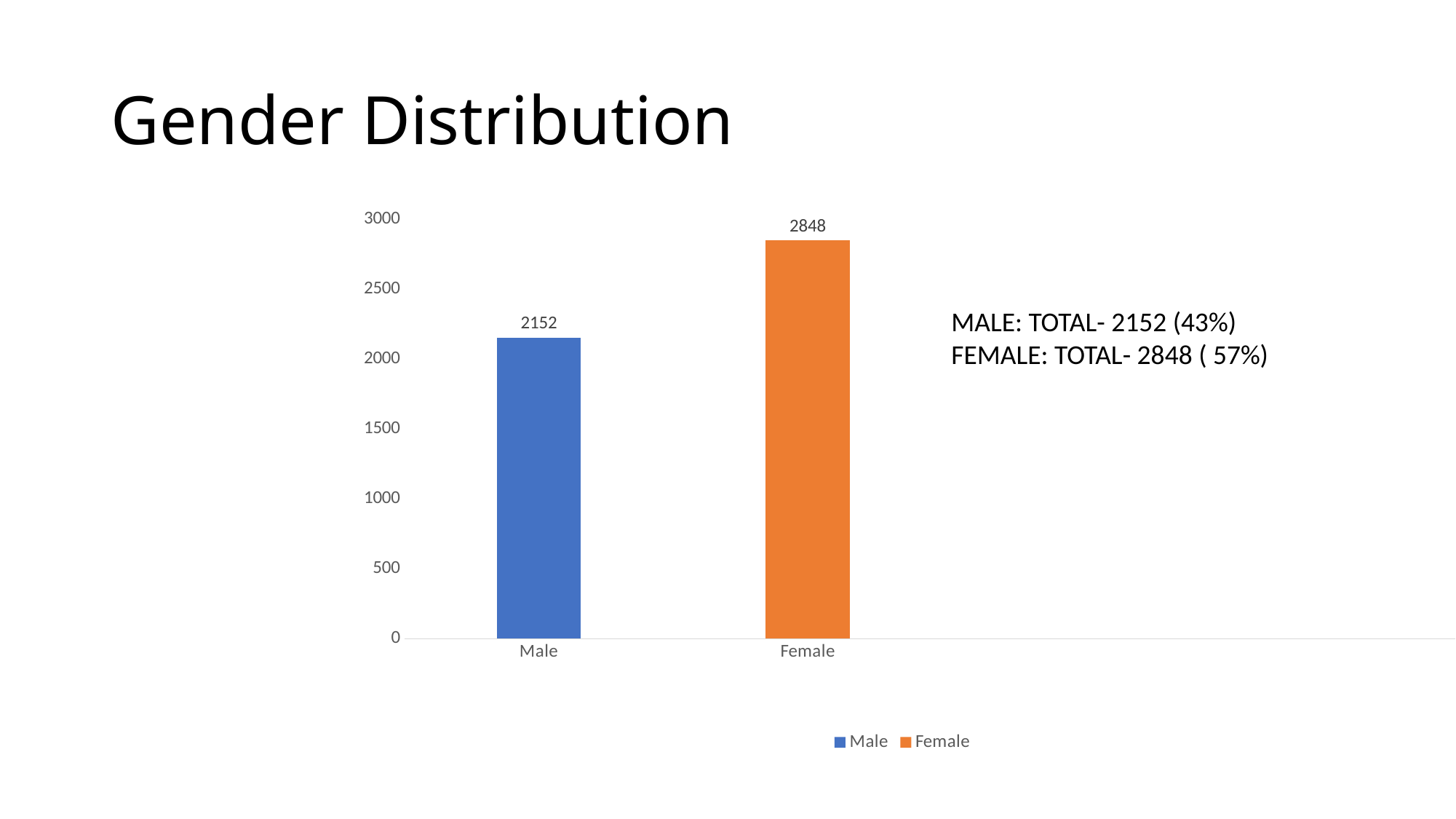
Which category has the lowest value? Male What is the value for Female? 2848 How many categories are shown on the x axis? 2 What colour is the Female bar? orange What is the value for Male? 2152 Is the value for Male greater or less than 2500? less Is the value for Female greater or less than 2500? greater Which is larger, the value for Male or the value for Female? Female What is the difference between the Female and Male values? 696 Which category has the highest value? Female What kind of chart is shown on the slide? bar chart How many entries does the legend list? 2